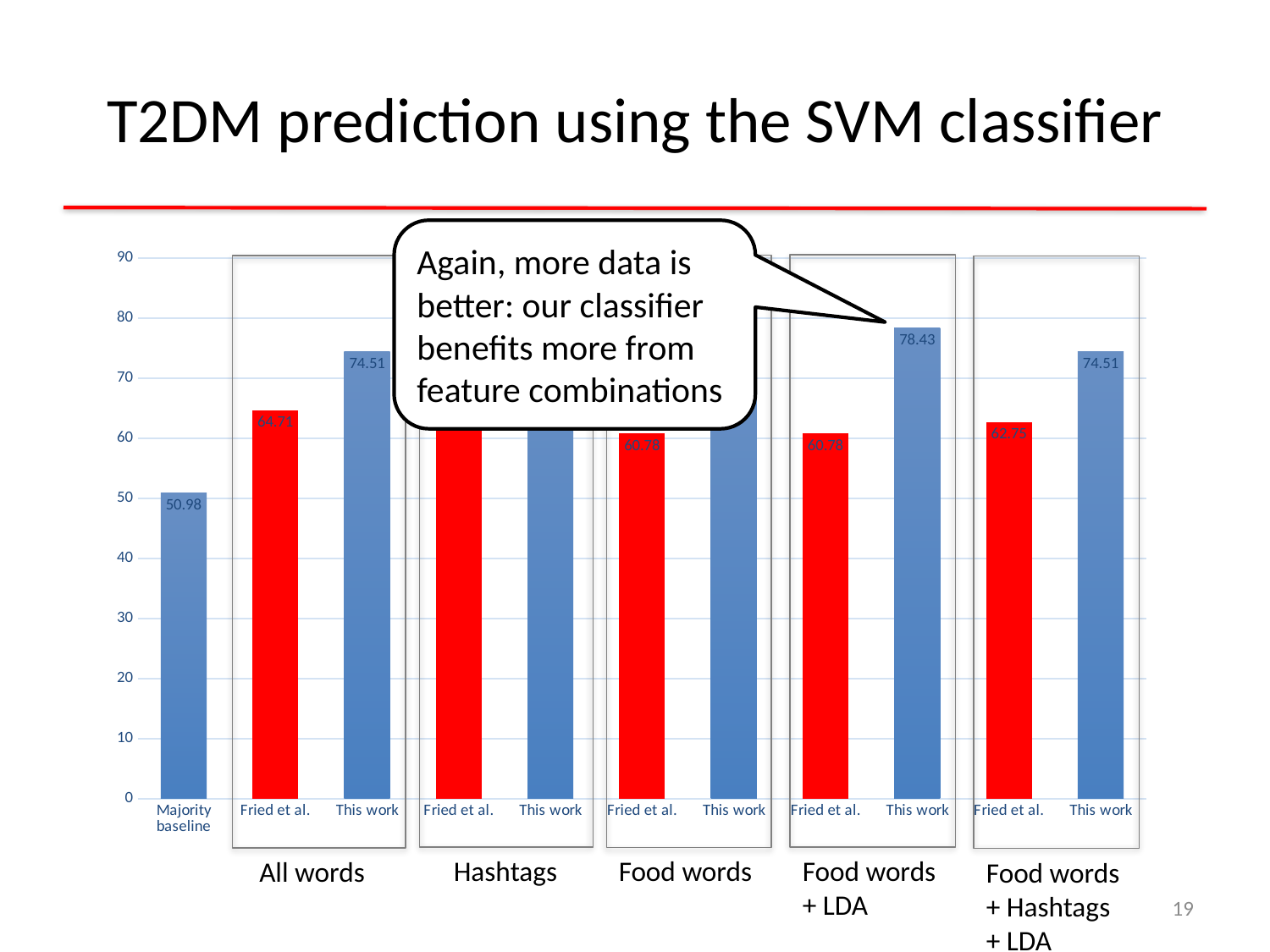
What is the value of the Fried et al. bar in the All words group? 64.71 In the All words group, how much higher is 'This work' than Fried et al.? 9.80 Which is larger: the Fried et al. value for All words or the Fried et al. value for Food words + Hashtags + LDA? All words What is the value of the Majority baseline bar? 50.98 What is the value of the Fried et al. bar in the Food words + LDA group? 60.78 Which bar has the lowest value on the chart? Majority baseline (50.98) Which bar has the highest value on the chart? This work, Food words + LDA (78.43) What value does the 'This work' bar reach in the Food words + LDA group? 78.43 What value does the 'This work' bar reach in the All words group? 74.51 What kind of chart is shown on the slide? Bar chart In the Food words + LDA group, what is the difference between 'This work' and Fried et al.? 17.65 What is the value of the Fried et al. bar in the Food words + Hashtags + LDA group? 62.75